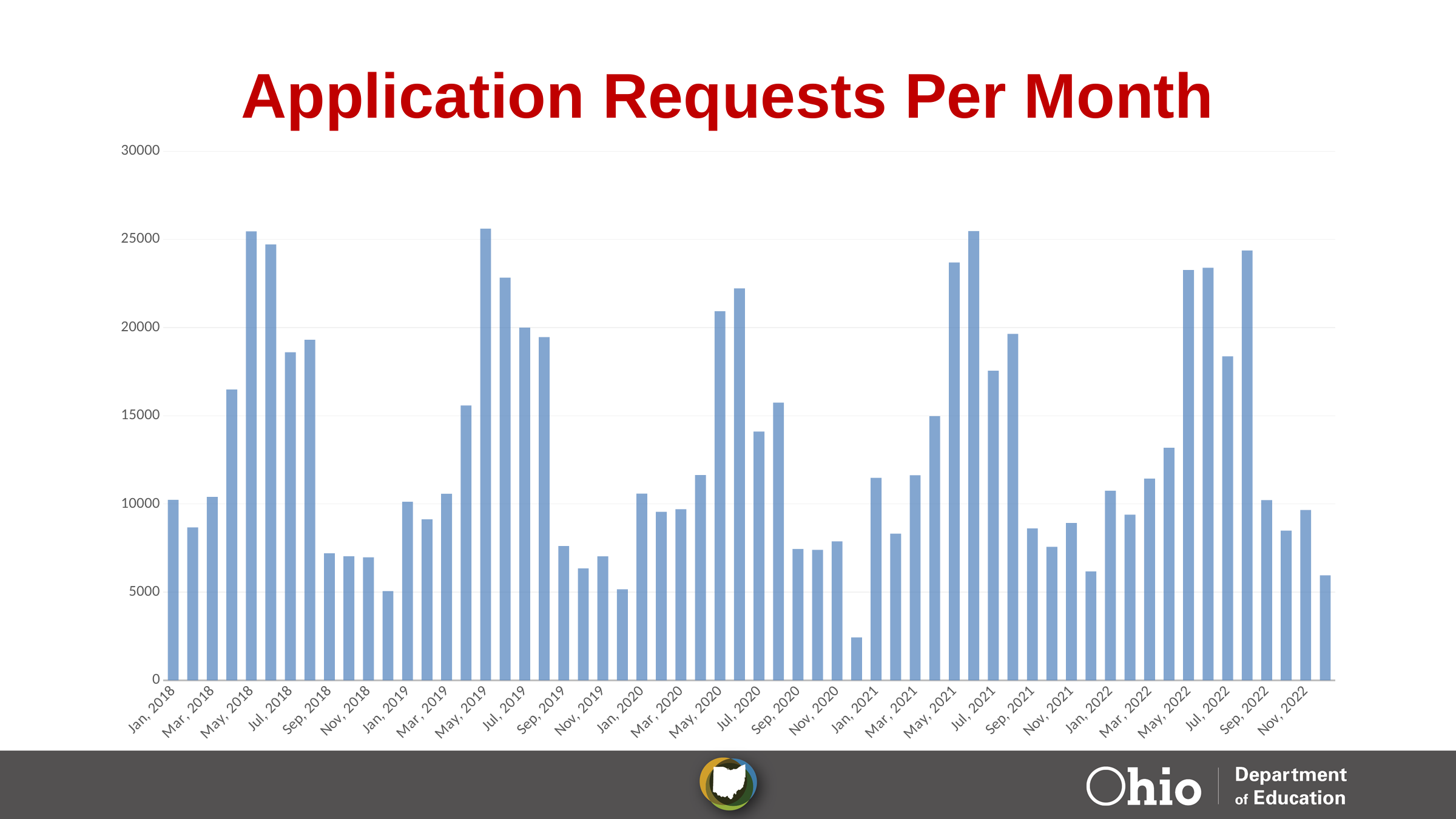
Do the values rise or fall from Jun, 2019 to Dec, 2019? Fall Is the value for Apr, 2018 greater or less than 15000? greater Is the value for Dec, 2020 greater or less than 5000? less Is the value for Sep, 2019 greater or less than 10000? less What kind of chart is shown on the slide? Bar chart Which is larger, the value for May, 2018 or the value for Sep, 2018? May, 2018 Which is larger, the value for Jun, 2020 or the value for Jul, 2020? Jun, 2020 Which month has the lowest number of application requests? Dec, 2020 What is the title of the chart? Application Requests Per Month What is the highest value shown on the vertical axis? 30000 Do the values rise or fall from Jan, 2018 to May, 2018? Rise